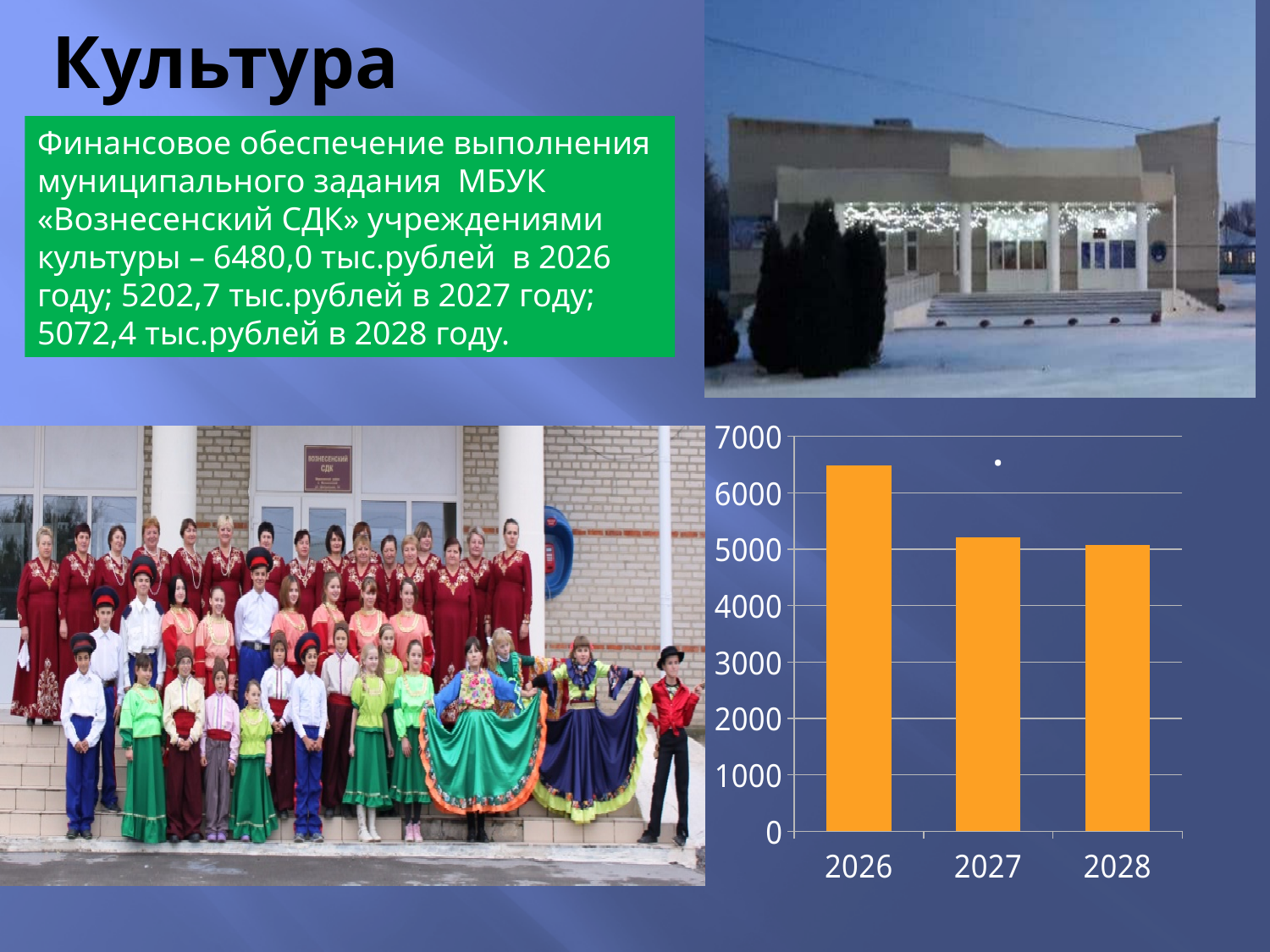
Which is larger, the value for 2026 or the value for 2027? 2026 According to the slide text, what is the financial provision for 2028? 5072,4 тыс.рублей Is the value for 2027 greater or less than 6000? less Which year has the highest bar in the chart? 2026 Do the values rise or fall from 2026 to 2028? fall What kind of chart is shown on the slide? bar chart Is the value for 2026 greater or less than 6000? greater How many bars (years) does the chart show? 3 Is the value for 2028 greater or less than 5000? greater What colour are the bars in the chart? orange According to the slide text, what is the financial provision for 2026? 6480,0 тыс.рублей